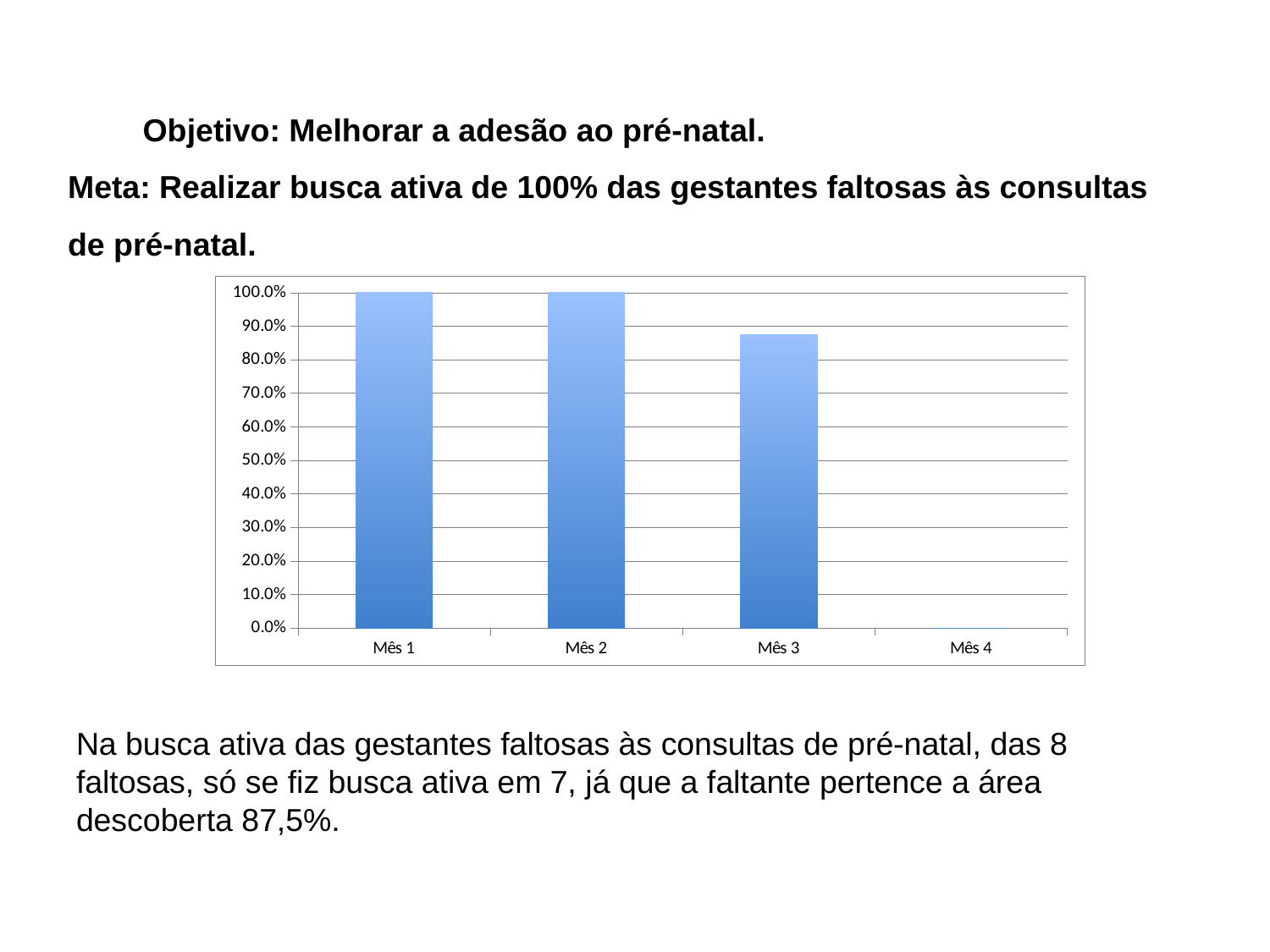
What is the highest value shown on the y axis of the chart? 100.0% Do the values rise or fall from Mês 2 to Mês 4? fall Is the value for Mês 3 greater or less than 80.0%? greater What kind of chart is shown on the slide? bar chart Which is larger, the value for Mês 1 or the value for Mês 3? Mês 1 What is the value for Mês 4? 0.0% Which category has the lowest value? Mês 4 Is the value for Mês 3 greater or less than 90.0%? less What is the value for Mês 2? 100.0% What is the value for Mês 1? 100.0% What is the difference between the values for Mês 1 and Mês 4? 100.0% How many categories are shown on the x axis of the chart? 4